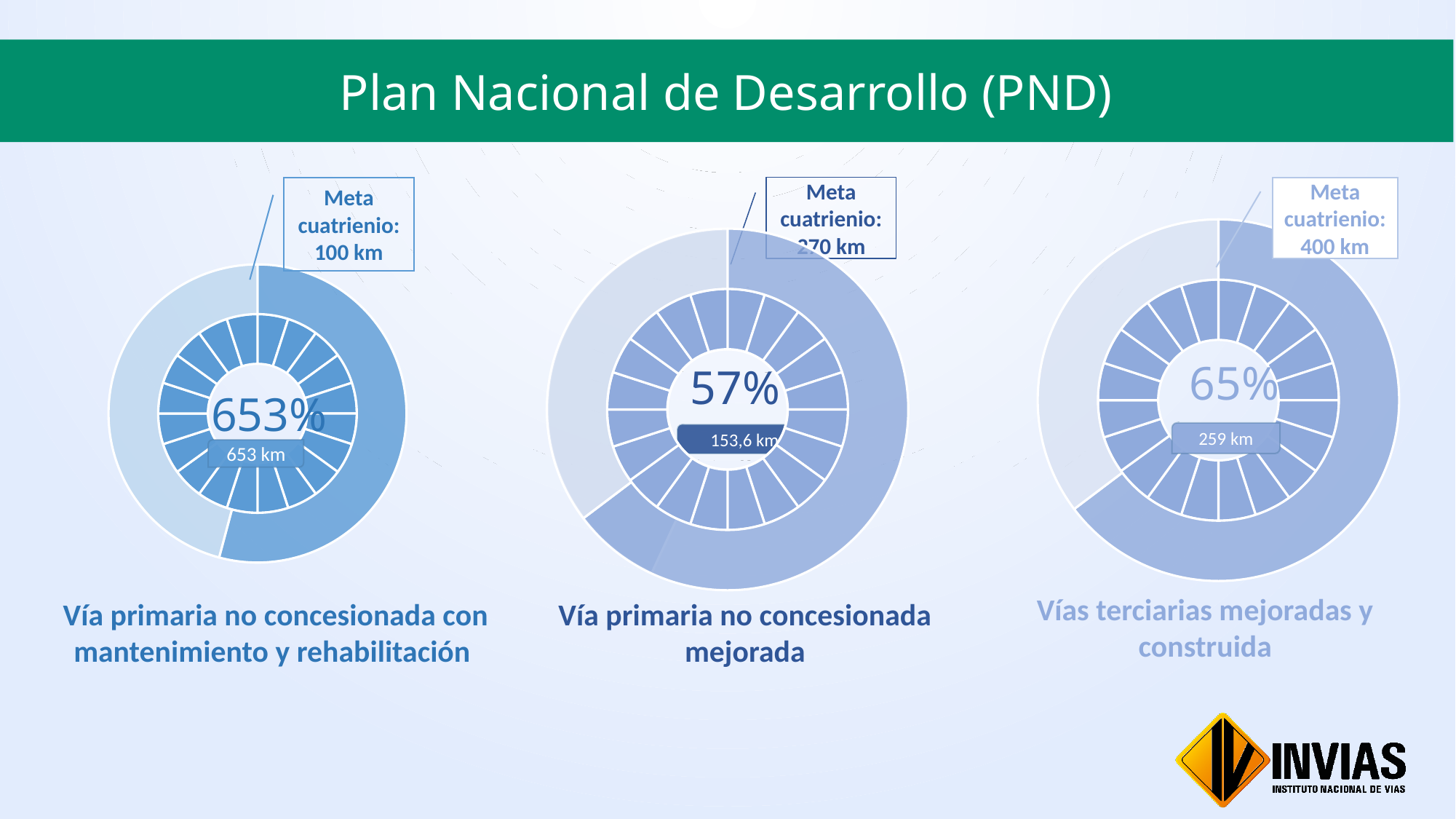
What percentage is shown in the centre of the 'Vías terciarias mejoradas y construida' chart? 65% How many kilometres are reported for 'Vía primaria no concesionada mejorada'? 153,6 km How many kilometres are reported for 'Vías terciarias mejoradas y construida'? 259 km What percentage is shown in the centre of the 'Vía primaria no concesionada con mantenimiento y rehabilitación' chart? 653% Which of the three charts shows the highest percentage? Vía primaria no concesionada con mantenimiento y rehabilitación How many donut charts are shown on the slide? 3 What percentage is shown in the centre of the 'Vía primaria no concesionada mejorada' chart? 57% Which of the three charts shows the lowest percentage? Vía primaria no concesionada mejorada What is the 'Meta cuatrienio' for the 'Vías terciarias mejoradas y construida' chart? 400 km What is the 'Meta cuatrienio' for the 'Vía primaria no concesionada con mantenimiento y rehabilitación' chart? 100 km Which is larger: the kilometres reported for 'Vías terciarias mejoradas y construida' or for 'Vía primaria no concesionada mejorada'? Vías terciarias mejoradas y construida How many kilometres are reported for 'Vía primaria no concesionada con mantenimiento y rehabilitación'? 653 km